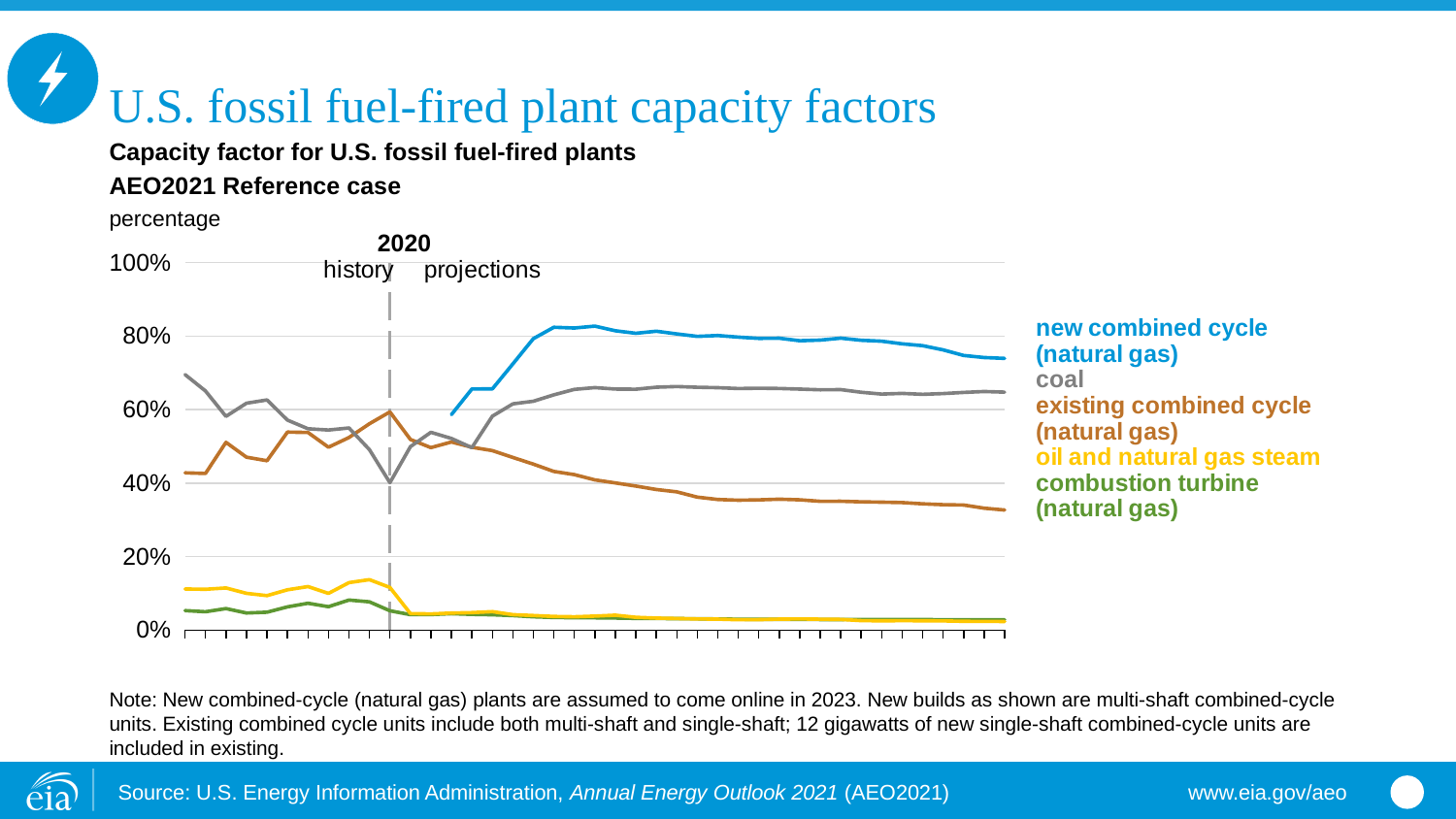
Does the capacity factor for existing combined cycle (natural gas) rise or fall over the projection period? fall What kind of chart is shown on the slide? line chart Which series has the highest capacity factor at the end of the projection period? new combined cycle (natural gas) How many series does the legend list? 5 At the end of the projection period, is the value for oil and natural gas steam greater or less than 20%? less At the end of the projection period, which is higher: coal or existing combined cycle (natural gas)? coal At the end of the projection period, is the value for new combined cycle (natural gas) greater or less than 60%? greater What year does the dashed vertical line separating history from projections mark? 2020 At the end of the projection period, is the value for combustion turbine (natural gas) greater or less than 20%? less Does the capacity factor for coal rise or fall from 2020 to the end of the projection period? rise What is the title of the chart? Capacity factor for U.S. fossil fuel-fired plants AEO2021 Reference case